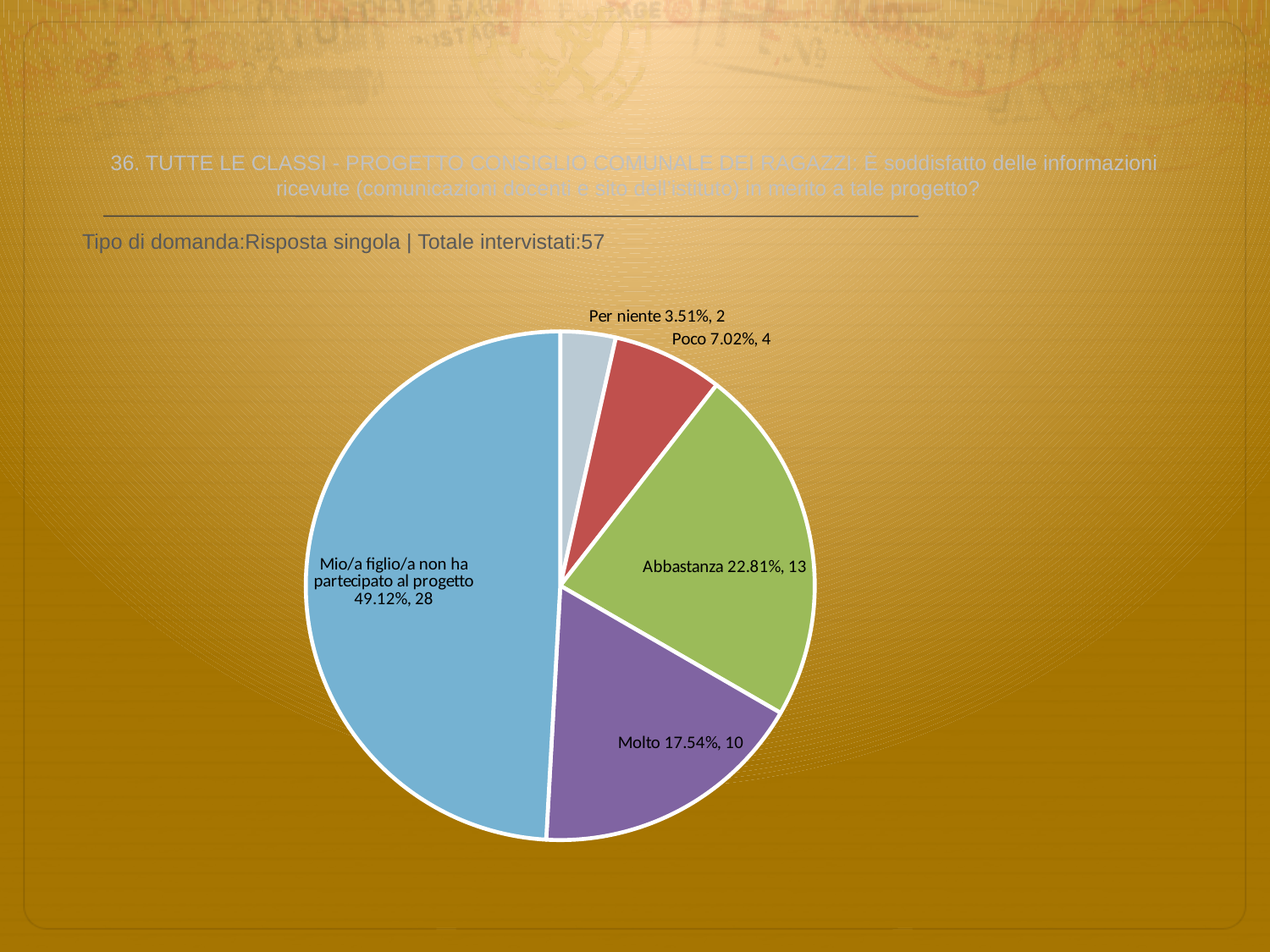
What kind of chart is shown on the slide? pie chart What colour is the 'Molto' slice? purple What is the total number of respondents across all slices? 57 What is the difference in count between 'Abbastanza' and 'Molto'? 3 What percentage share does the 'Abbastanza' slice have? 22.81% Which is larger, the 'Poco' slice or the 'Per niente' slice? Poco How many respondents answered 'Mio/a figlio/a non ha partecipato al progetto'? 28 How many slices does the pie chart have? 5 Which category has the smallest slice of the pie? Per niente Which category has the largest slice of the pie? Mio/a figlio/a non ha partecipato al progetto How many respondents answered 'Molto'? 10 What percentage share does the 'Per niente' slice have? 3.51%